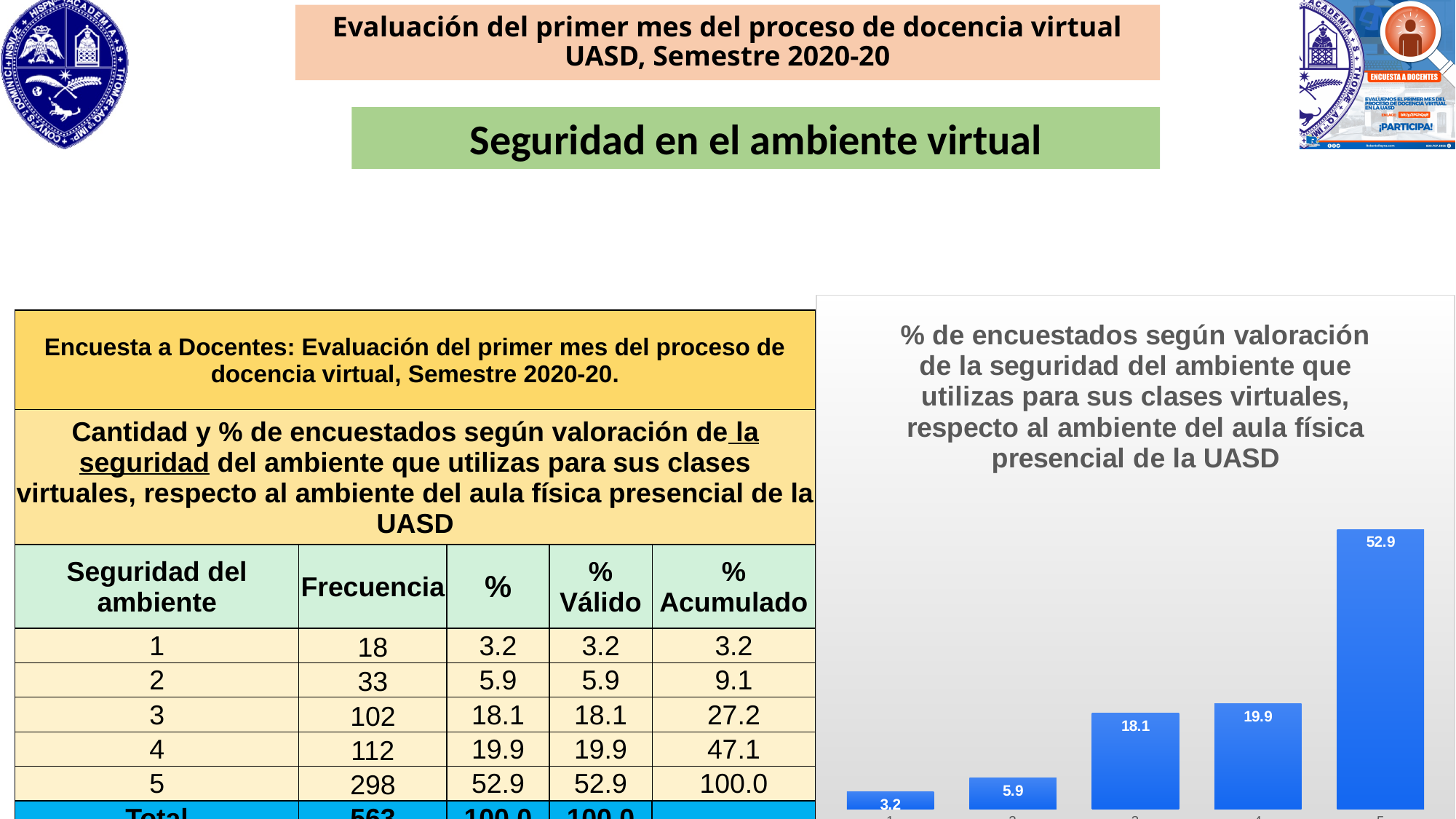
What is the value for category 4 in the chart? 19.9 Which category has the highest value in the chart? 5 Do the values rise or fall from category 1 to category 5? rise What is the value for category 3 in the chart? 18.1 What is the difference between the values for category 5 and category 4? 33.0 Which category has the lowest value in the chart? 1 How many bars are plotted in the chart? 5 What is the difference between the values for category 2 and category 1? 2.7 Which is larger, the value for category 3 or the value for category 2? category 3 What kind of chart is shown on the slide? bar chart What is the value for category 1 in the chart? 3.2 What is the value for category 5 in the chart? 52.9